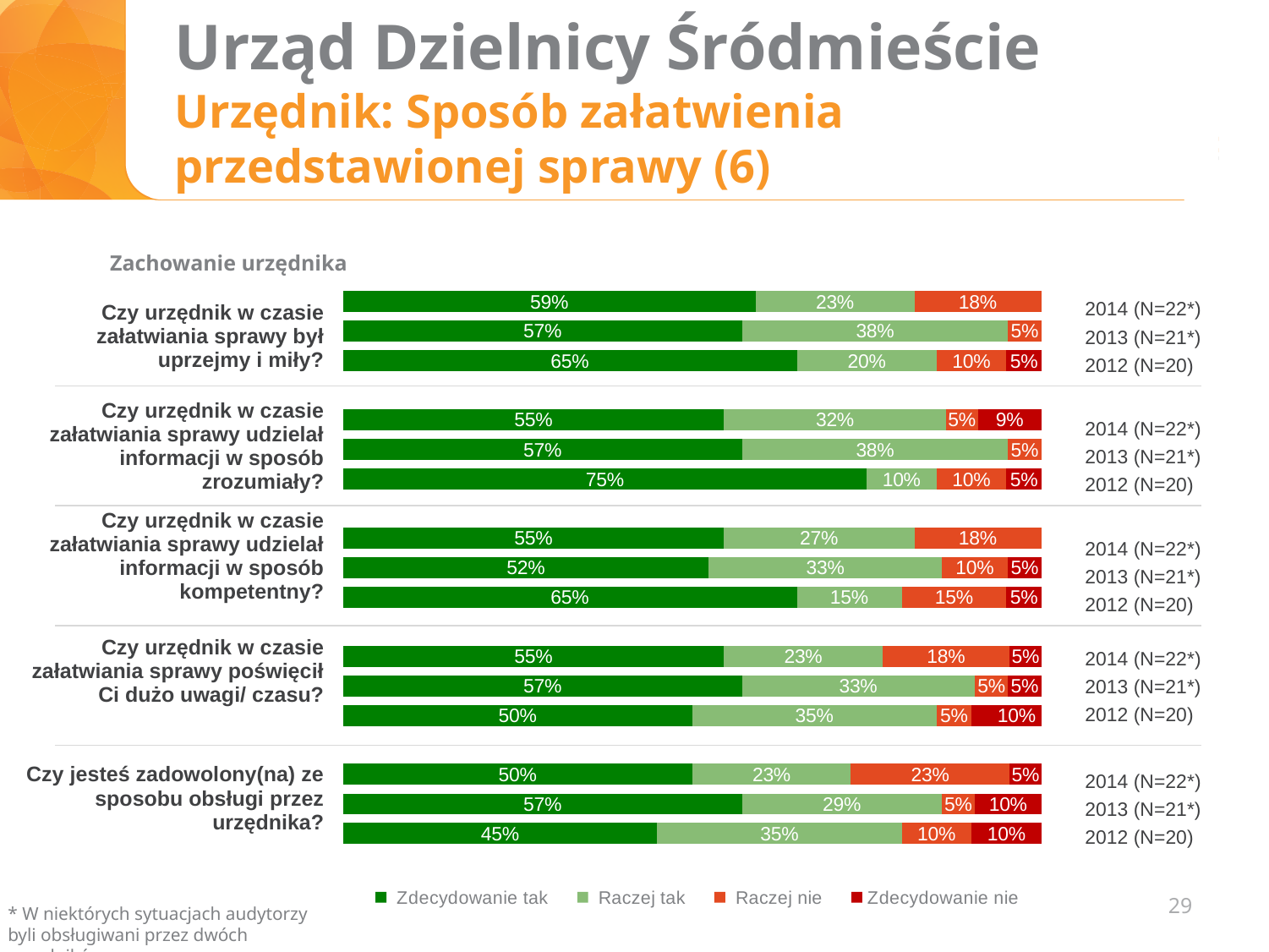
In the chart for "Czy jesteś zadowolony(na) ze sposobu obsługi przez urzędnika?", which year has the lowest "Zdecydowanie tak" value? 2012 (N=20) What is the first entry in the legend? Zdecydowanie tak How many bars are in the chart for "Czy jesteś zadowolony(na) ze sposobu obsługi przez urzędnika?"? 3 How many series does the legend list? 4 In the chart for "Czy urzędnik w czasie załatwiania sprawy udzielał informacji w sposób zrozumiały?", what is the "Zdecydowanie tak" value for 2012 (N=20)? 75% In the chart for "Czy urzędnik w czasie załatwiania sprawy był uprzejmy i miły?", what is the difference between the "Raczej tak" values for 2013 and 2014? 15 percentage points In the chart for "Czy urzędnik w czasie załatwiania sprawy był uprzejmy i miły?", what is the "Zdecydowanie tak" value for 2012 (N=20)? 65% In the chart for "Czy urzędnik w czasie załatwiania sprawy udzielał informacji w sposób zrozumiały?", which year has the highest "Zdecydowanie tak" share? 2012 (N=20) In the chart for "Czy jesteś zadowolony(na) ze sposobu obsługi przez urzędnika?", which year has the larger "Zdecydowanie tak" value, 2013 or 2012? 2013 (N=21*) In the chart for "Czy urzędnik w czasie załatwiania sprawy poświęcił Ci dużo uwagi/ czasu?", what is the "Raczej tak" value for 2012 (N=20)? 35% What kind of chart is used on this slide? Stacked bar chart In the chart for "Czy urzędnik w czasie załatwiania sprawy udzielał informacji w sposób kompetentny?", what is the "Raczej tak" value for 2013 (N=21*)? 33%